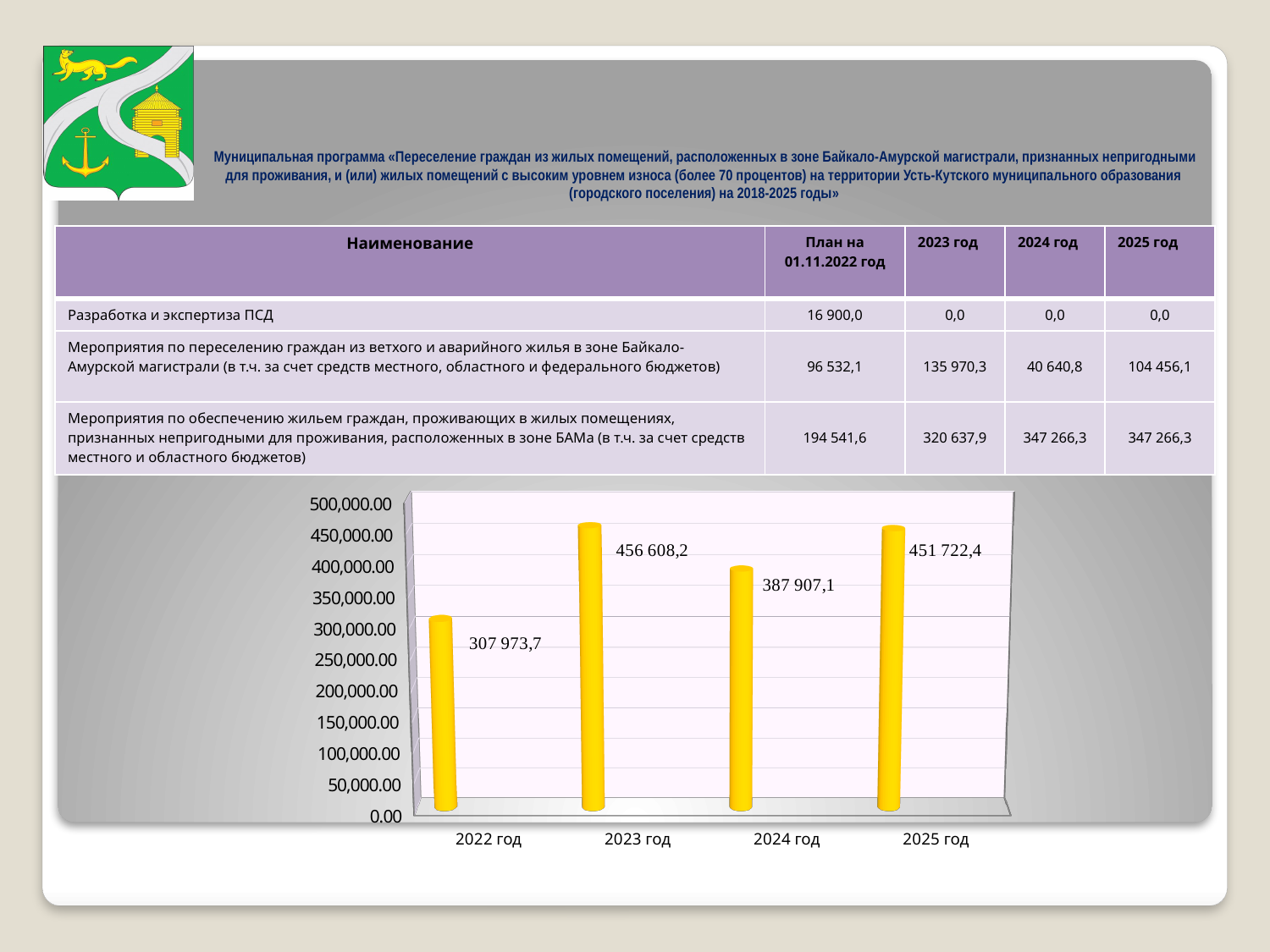
What is the value shown for 2024 год in the chart? 387 907,1 What is the value shown for 2022 год in the chart? 307 973,7 Which is larger in the chart, the value for 2024 год or the value for 2025 год? 2025 год Which year has the lowest value in the chart? 2022 год Which year has the highest value in the chart? 2023 год How many bars (categories) does the chart show? 4 What type of chart is shown on the slide? bar chart What is the difference between the values for 2023 год and 2022 год in the chart? 148 634,5 Does the value rise or fall from 2023 год to 2024 год in the chart? fall Is the value for 2024 год greater or less than 400,000.00? less What is the value shown for 2025 год in the chart? 451 722,4 What is the value shown for 2023 год in the chart? 456 608,2